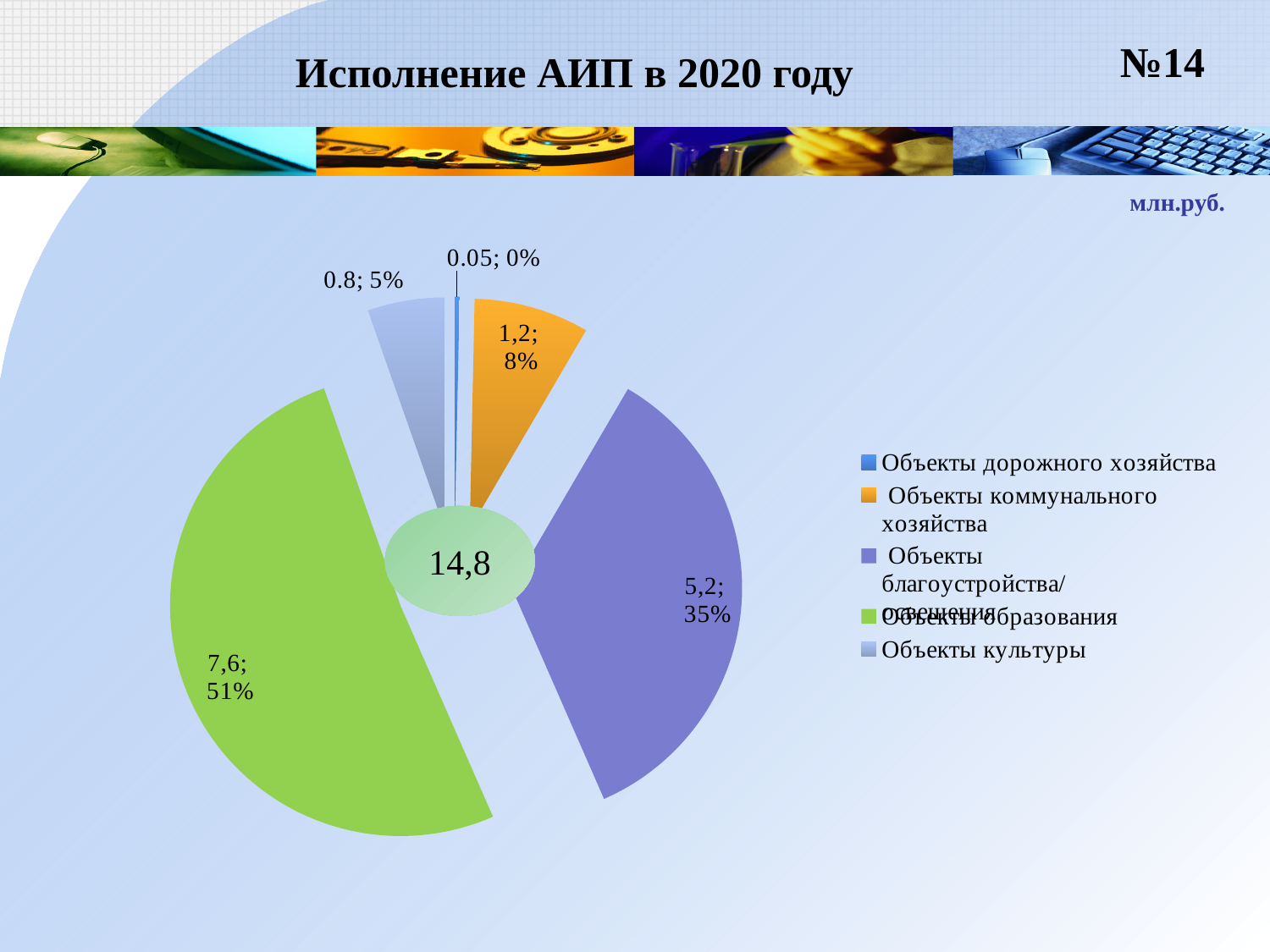
What is the value for Объекты коммунального хозяйства? 1,2 Which category has the largest slice of the pie? Объекты образования What is the value for Объекты образования? 7,6 What is the value for Объекты дорожного хозяйства? 0.05 How many categories does the legend list? 5 Which is larger, the value for Объекты коммунального хозяйства or the value for Объекты культуры? Объекты коммунального хозяйства What share of the pie does Объекты благоустройства/освещения represent? 35% What is the value for Объекты благоустройства/освещения? 5,2 Which category has the smallest slice of the pie? Объекты дорожного хозяйства What kind of chart is shown on the slide? pie chart What is the value for Объекты культуры? 0.8 What share of the pie does Объекты культуры represent? 5%